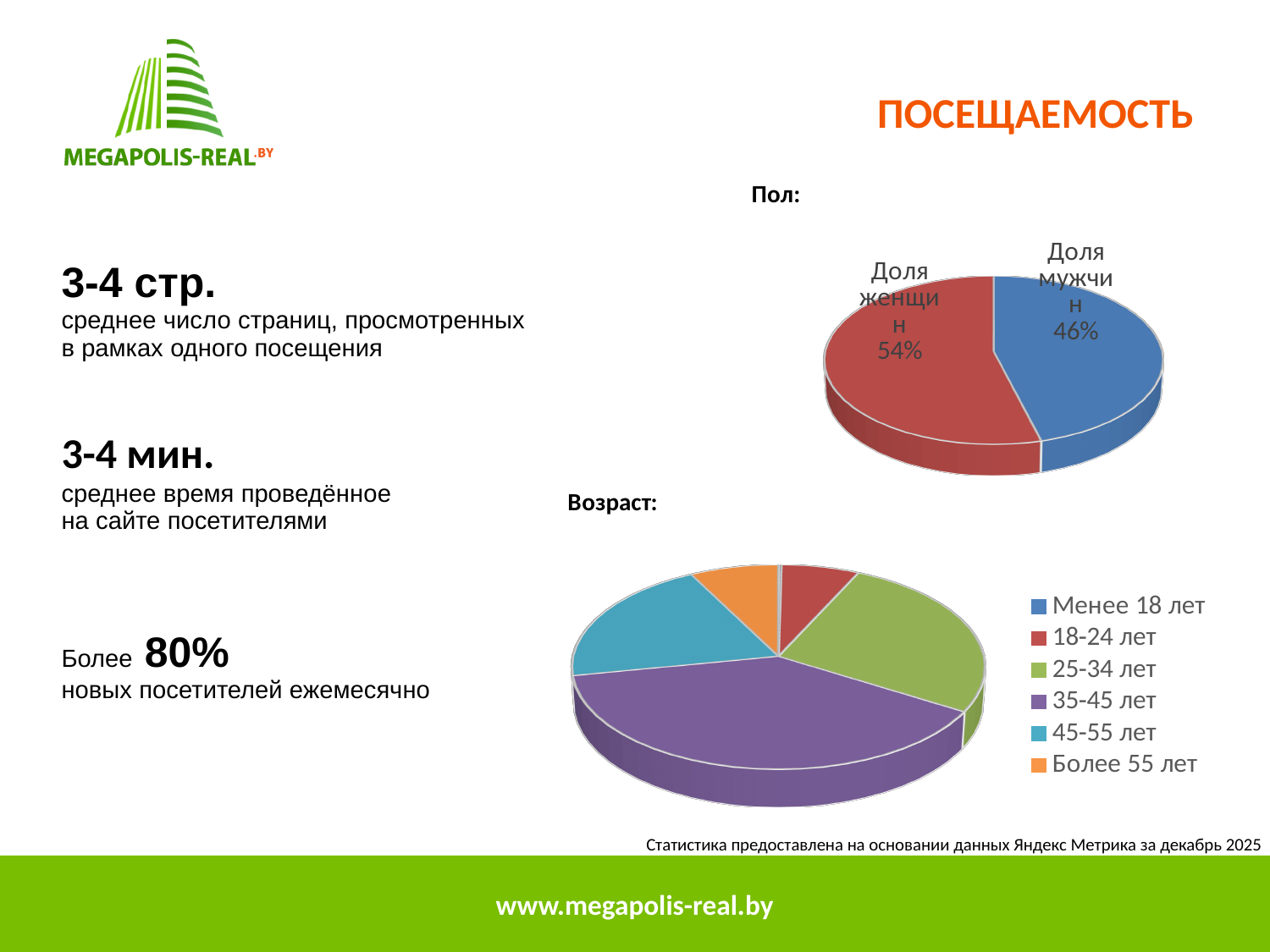
On the 'Пол:' pie chart, how many slices are there? 2 What kind of chart is the 'Пол:' chart? Pie chart On the 'Возраст:' pie chart, what colour represents the '35-45 лет' category? Purple On the 'Пол:' pie chart, what share is shown for 'Доля мужчин'? 46% On the 'Пол:' pie chart, which is larger: the share of women or the share of men? Доля женщин On the 'Возраст:' pie chart, which age group has the largest slice? 35-45 лет On the 'Пол:' pie chart, which slice is the largest? Доля женщин On the 'Пол:' pie chart, which slice is the smallest? Доля мужчин On the 'Пол:' pie chart, what is the difference between the share of women and the share of men? 8% On the 'Пол:' pie chart, what share is shown for 'Доля женщин'? 54% On the 'Возраст:' pie chart, which slice is larger: '25-34 лет' or 'Более 55 лет'? 25-34 лет How many categories does the legend of the 'Возраст:' chart list? 6